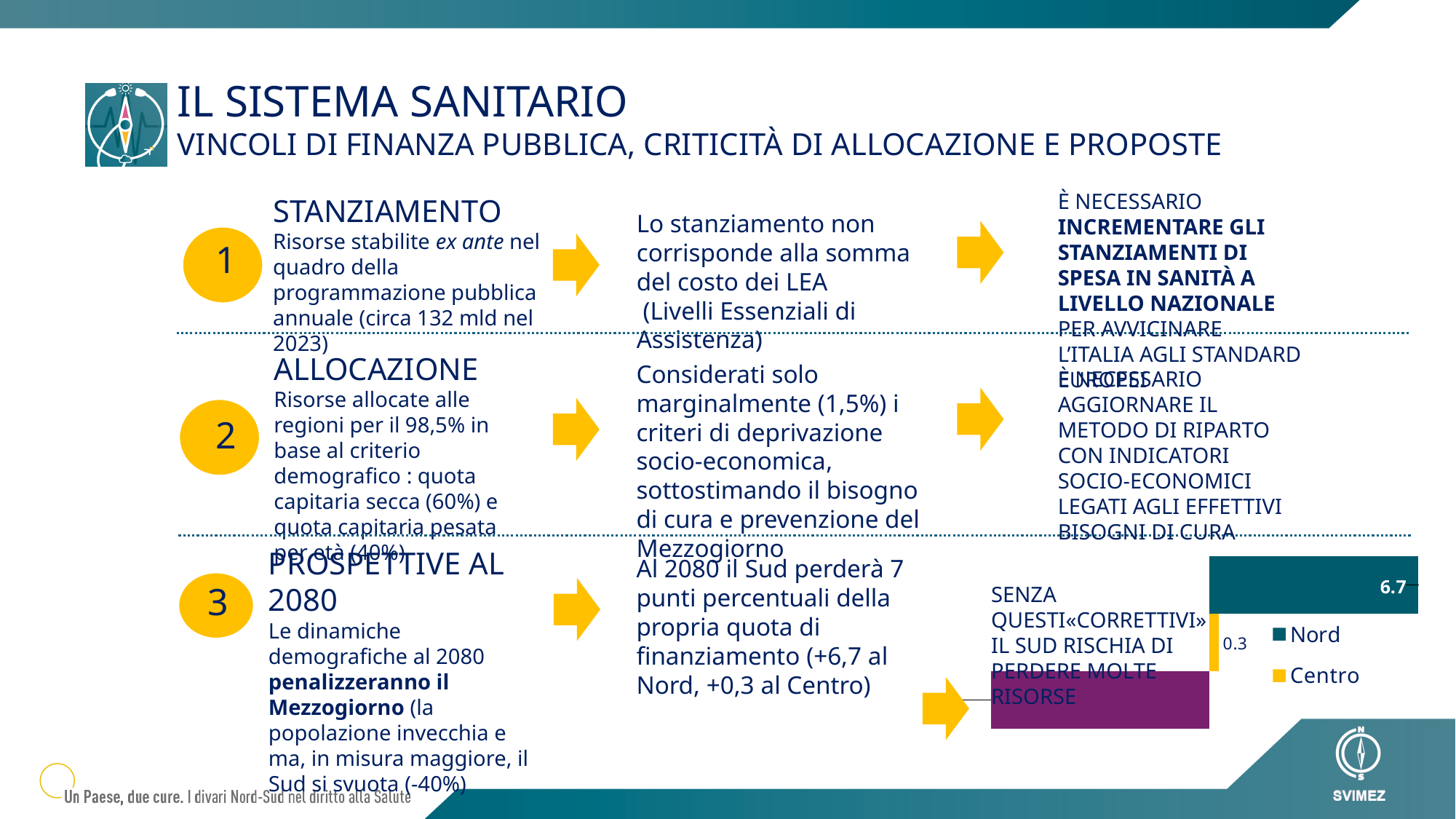
In the bar chart at the bottom right, which of the labelled series has the lowest value? Centro How many bars are drawn in the bar chart at the bottom right? 3 What kind of chart is shown at the bottom right of the slide? Bar chart In the bar chart at the bottom right, what colour is the bar for Centro? Yellow In the bar chart at the bottom right, what colour is the bar for Nord? Dark teal In the bar chart at the bottom right, which is larger, the value for Nord or the value for Centro? Nord In the bar chart at the bottom right, what is the value for Nord? 6.7 How many series does the legend of the bar chart at the bottom right list? 2 In the bar chart at the bottom right, which of the labelled series has the highest value? Nord In the bar chart at the bottom right, what is the value for Centro? 0.3 In the bar chart at the bottom right, what is the difference between the values for Nord and Centro? 6.4